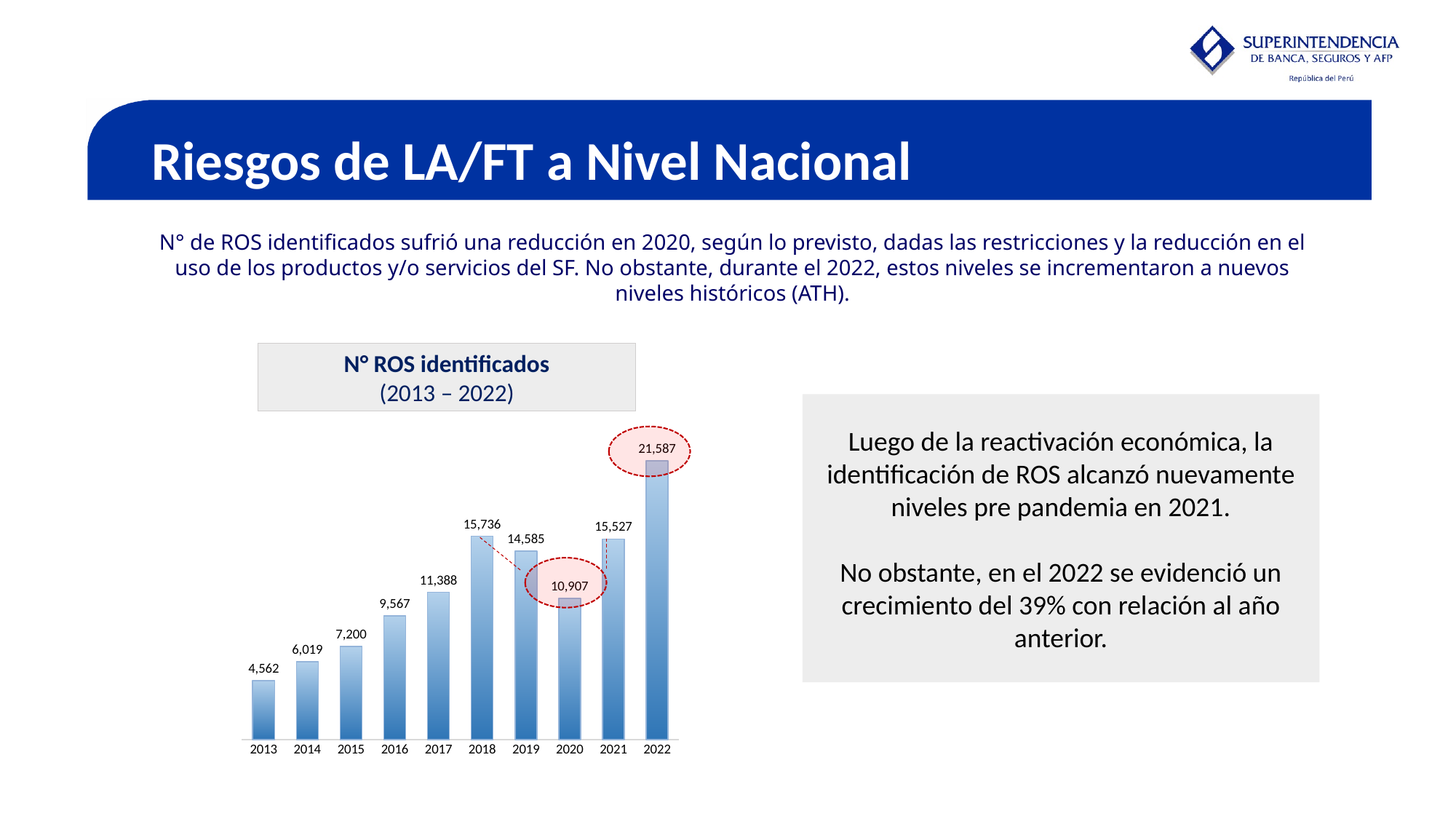
Which year has the highest value in the N° ROS identificados chart? 2022 What is the value for 2018 in the N° ROS identificados chart? 15,736 What is the value for 2013 in the N° ROS identificados chart? 4,562 What is the difference between the values for 2022 and 2021 in the N° ROS identificados chart? 6,060 Which is larger in the N° ROS identificados chart, the value for 2018 or the value for 2021? 2018 Which year has the lowest value in the N° ROS identificados chart? 2013 What is the value for 2020 in the N° ROS identificados chart? 10,907 What kind of chart is the N° ROS identificados chart? Bar chart What is the value for 2022 in the N° ROS identificados chart? 21,587 What is the title of the chart on the slide? N° ROS identificados (2013 – 2022) How many years are shown in the N° ROS identificados chart? 10 What is the difference between the values for 2019 and 2020 in the N° ROS identificados chart? 3,678